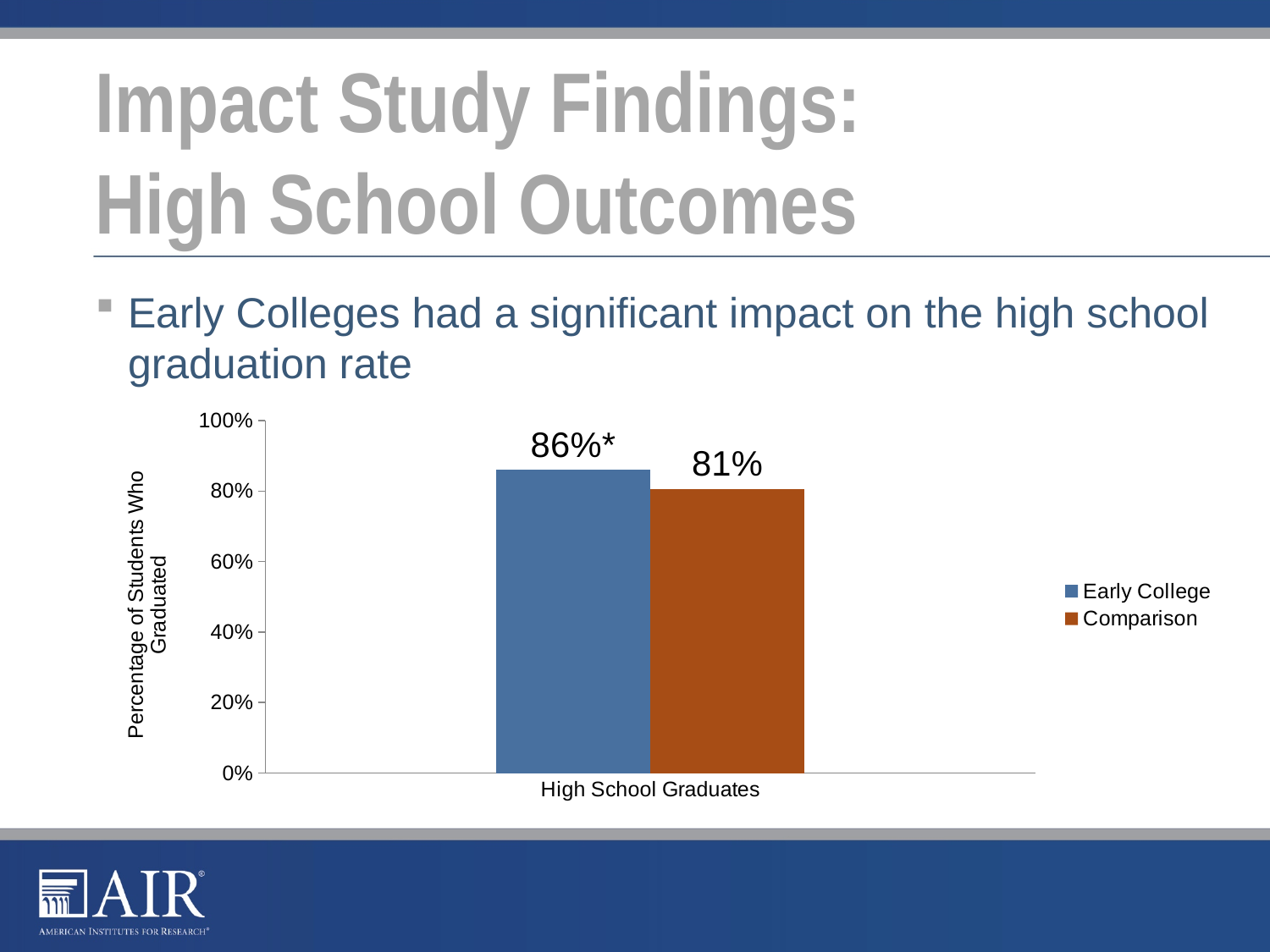
What is the difference between the Early College and Comparison values for High School Graduates? 5% What is the value for Early College for High School Graduates? 86%* What colour is the Comparison bar? Orange-brown Which series has the lowest value for High School Graduates? Comparison Is the value for Comparison greater or less than 80%? greater Which series has the higher value for High School Graduates, Early College or Comparison? Early College How many categories are shown on the x axis? 1 What is the value for Comparison for High School Graduates? 81% Is the value for Early College greater or less than 100%? less What kind of chart is shown on the slide? Bar chart What is the label of the y axis? Percentage of Students Who Graduated How many series does the legend list? 2